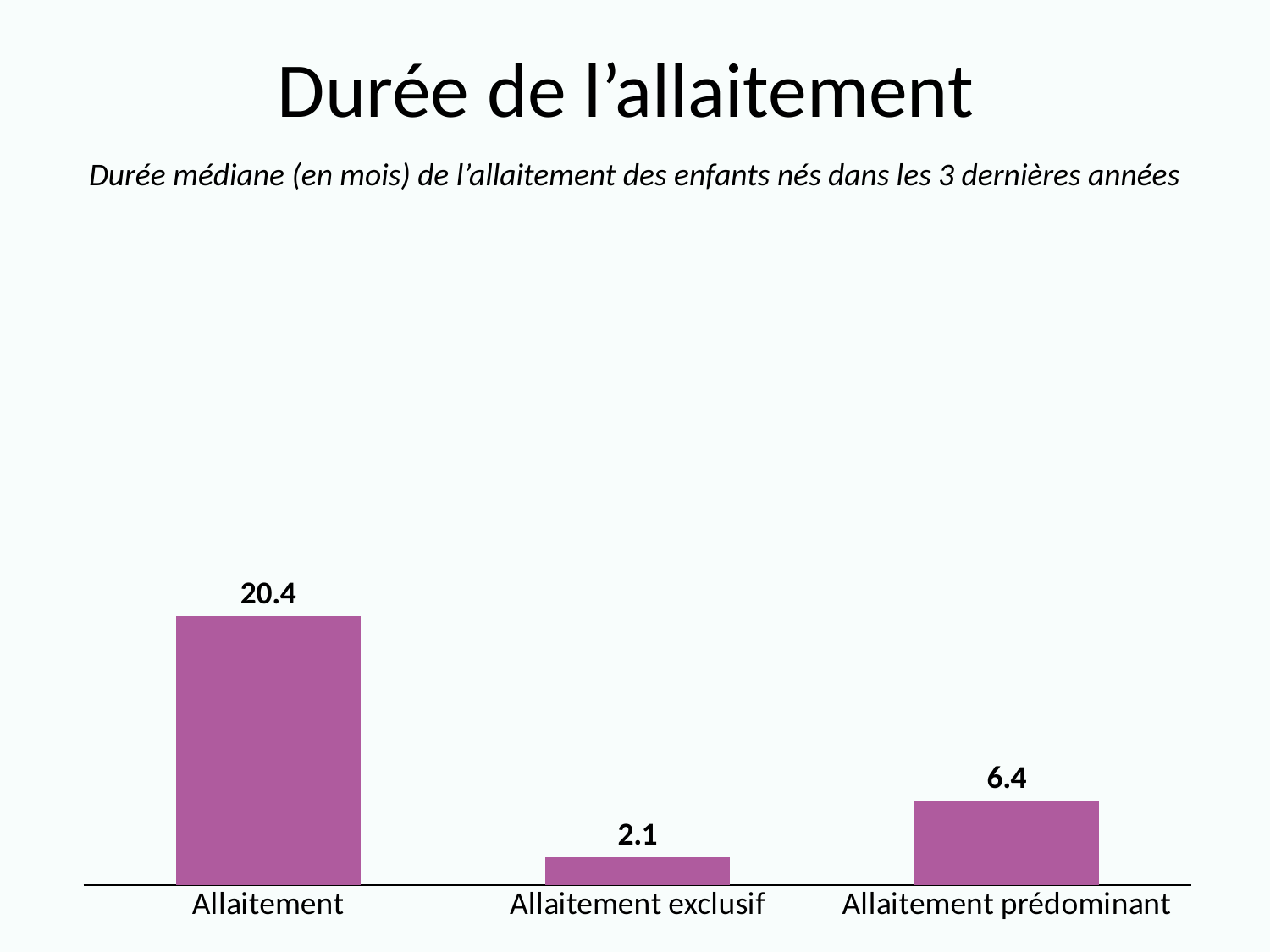
Which category has the lowest value? Allaitement exclusif How many categories are shown in the chart? 3 What kind of chart is shown on the slide? Bar chart What is the median duration for Allaitement exclusif? 2.1 Which category has the highest value? Allaitement What is the median duration for Allaitement? 20.4 What is the median duration for Allaitement prédominant? 6.4 What is the title of the slide? Durée de l'allaitement What is the difference between the values for Allaitement and Allaitement prédominant? 14.0 Which is larger, the value for Allaitement exclusif or Allaitement prédominant? Allaitement prédominant In what unit is the median duration expressed, according to the subtitle? mois What is the difference between the values for Allaitement prédominant and Allaitement exclusif? 4.3